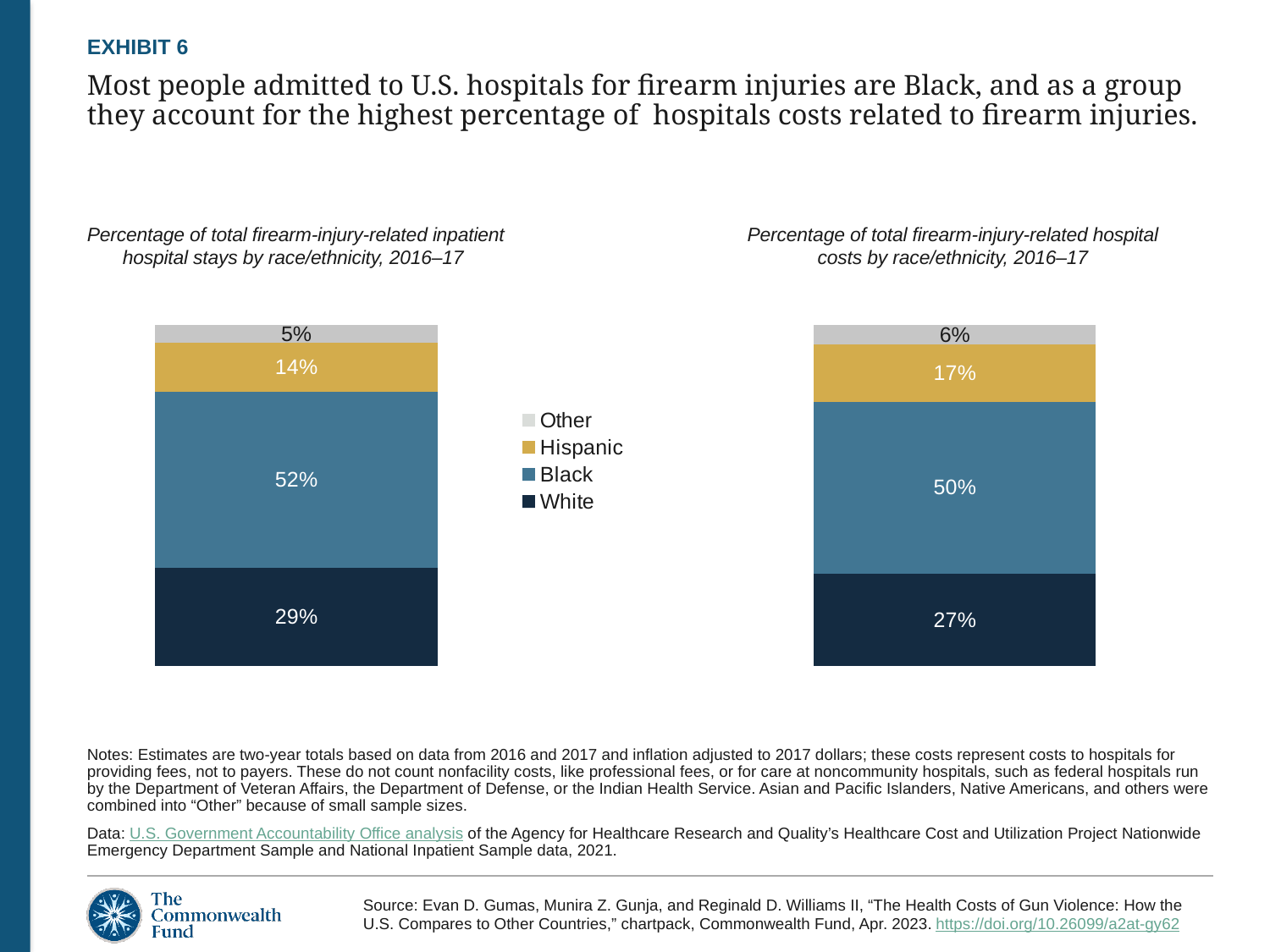
What kind of chart is used on this slide? Stacked bar chart In the chart on the left (inpatient hospital stays), what is the difference between the Black and White percentages? 23 percentage points In the chart on the right (hospital costs), what percentage is shown for Hispanic? 17% Which colour represents Hispanic in the legend? Gold/yellow In the chart on the right (hospital costs), which race/ethnicity group has the highest percentage? Black In the chart on the right (hospital costs), what percentage is shown for Other? 6% How many series does the legend list? 4 In the chart on the left (inpatient hospital stays), which race/ethnicity group has the lowest percentage? Other In the chart on the left (inpatient hospital stays), what percentage is shown for White? 29% In the chart on the right (hospital costs), what is the total of the stacked bar? 100% Which is larger: the White share of hospital stays in the left chart or the White share of hospital costs in the right chart? White share of hospital stays (29%) In the chart on the left (inpatient hospital stays), what percentage is shown for Black? 52%